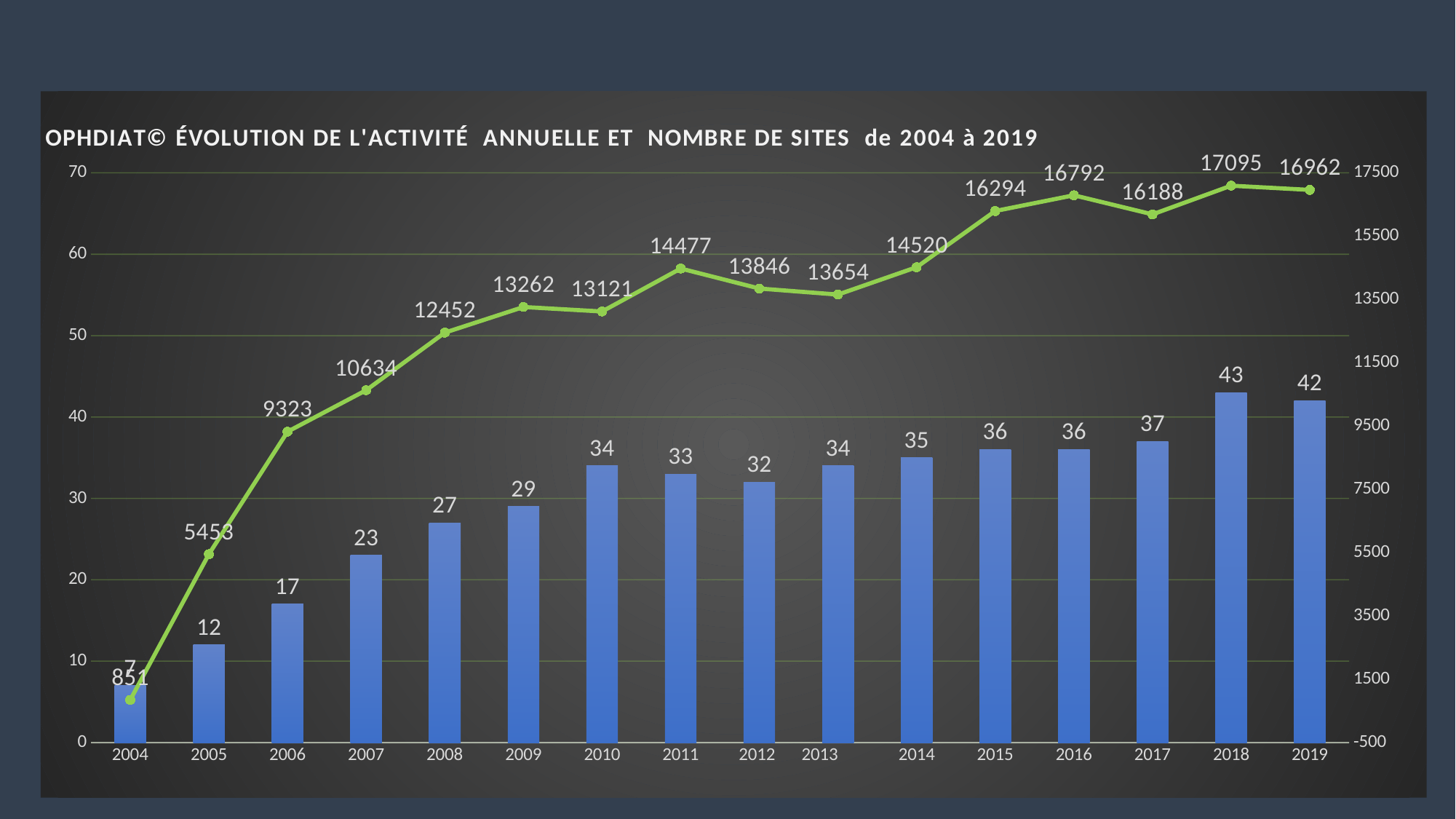
What is the difference between the bar values for 2018 and 2019? 1 Which year has the tallest bar? 2018 What is the value of the bar for 2010? 34 In which year does the line series reach its highest value? 2018 What is the difference between the line values for 2018 and 2017? 907 What value does the line series show for 2004? 851 Which year has the larger bar value, 2011 or 2012? 2011 Do the bar values generally rise or fall from 2004 to 2019? Rise What value does the line series show for 2015? 16294 Which year has the lowest bar value? 2004 How many years are shown on the x axis? 16 What kinds of chart are combined on this slide? Bar chart and line chart